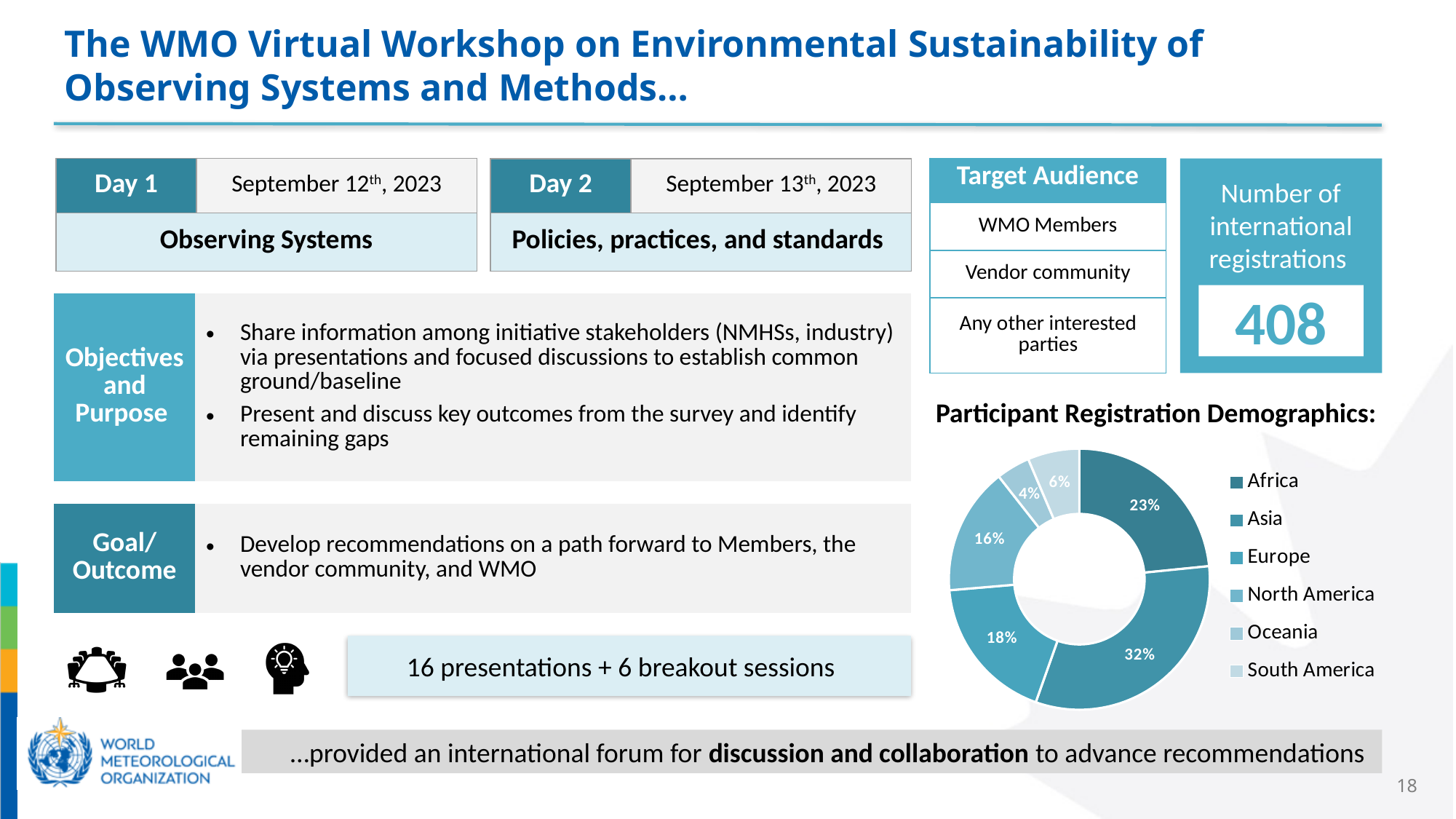
In the Participant Registration Demographics chart, what share of registrations is from North America? 16% In the Participant Registration Demographics chart, what is the difference in percentage points between Asia and Africa? 9 percentage points In the Participant Registration Demographics chart, what share of registrations is from Europe? 18% In the Participant Registration Demographics chart, which has a larger share, Europe or North America? Europe How many regions are shown in the Participant Registration Demographics chart? 6 In the Participant Registration Demographics chart, what share of registrations is from Asia? 32% In the Participant Registration Demographics chart, which region has the largest share of registrations? Asia In the Participant Registration Demographics chart, what share of registrations is from Oceania? 4% In the Participant Registration Demographics chart, what is the combined share of Oceania and South America? 10% In the Participant Registration Demographics chart, what share of registrations is from Africa? 23% What kind of chart is used for Participant Registration Demographics? Donut (pie) chart In the Participant Registration Demographics chart, which region has the smallest share of registrations? Oceania